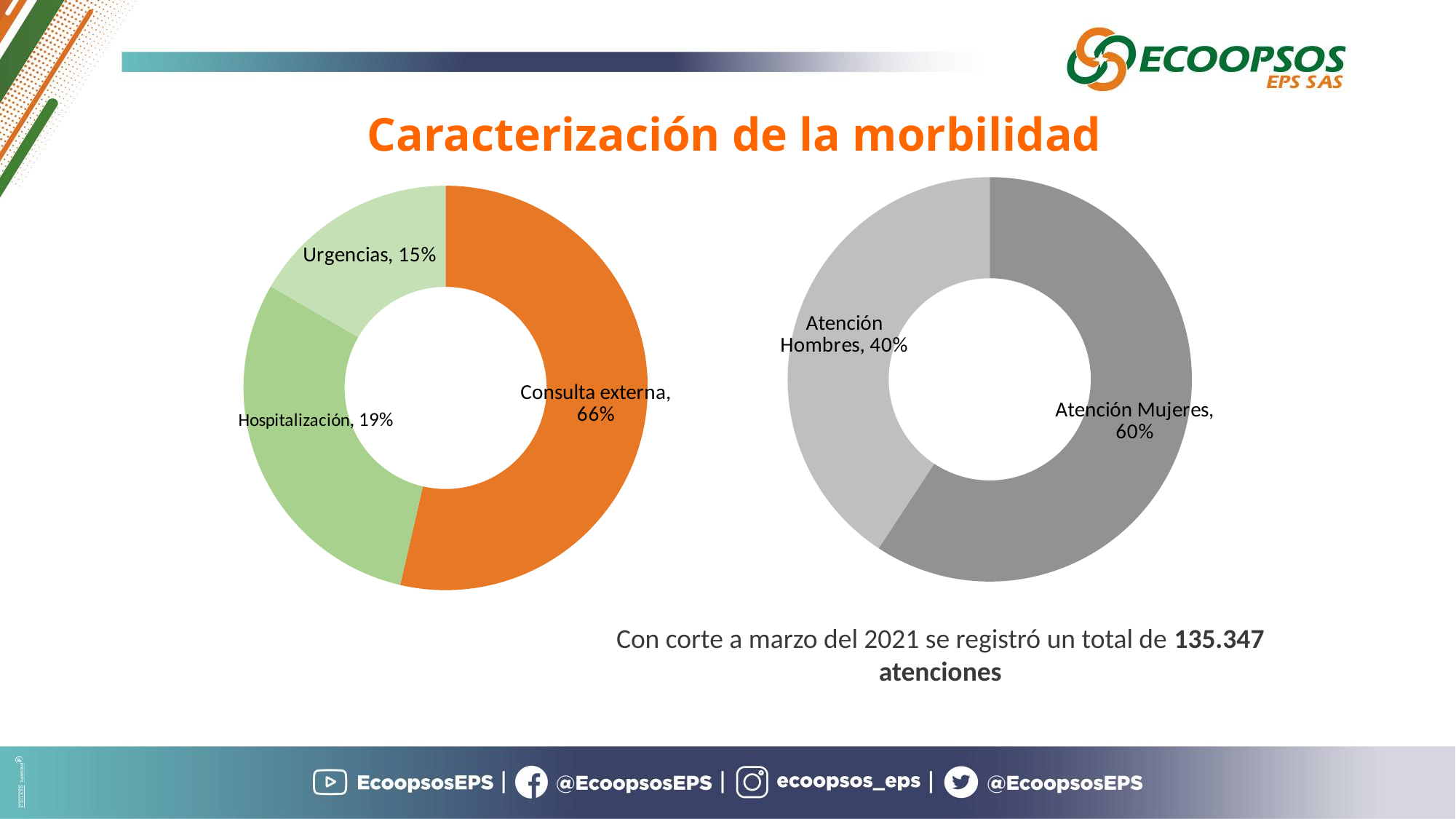
In the right chart, what is the share for Atención Hombres? 40% In the left chart, what is the difference in percentage points between Consulta externa and Hospitalización? 47 In the right chart, what is the share for Atención Mujeres? 60% In the right chart, what is the difference in percentage points between Atención Mujeres and Atención Hombres? 20 In the left chart, which category has the largest share? Consulta externa What kind of chart is the left chart? Pie chart (doughnut) In the left chart, what is the share for Hospitalización? 19% In the left chart, which category has the smallest share? Urgencias In the left chart, what is the share for Consulta externa? 66% In the right chart, which is larger, Atención Mujeres or Atención Hombres? Atención Mujeres In the left chart, how many categories are shown? 3 In the left chart, what is the share for Urgencias? 15%